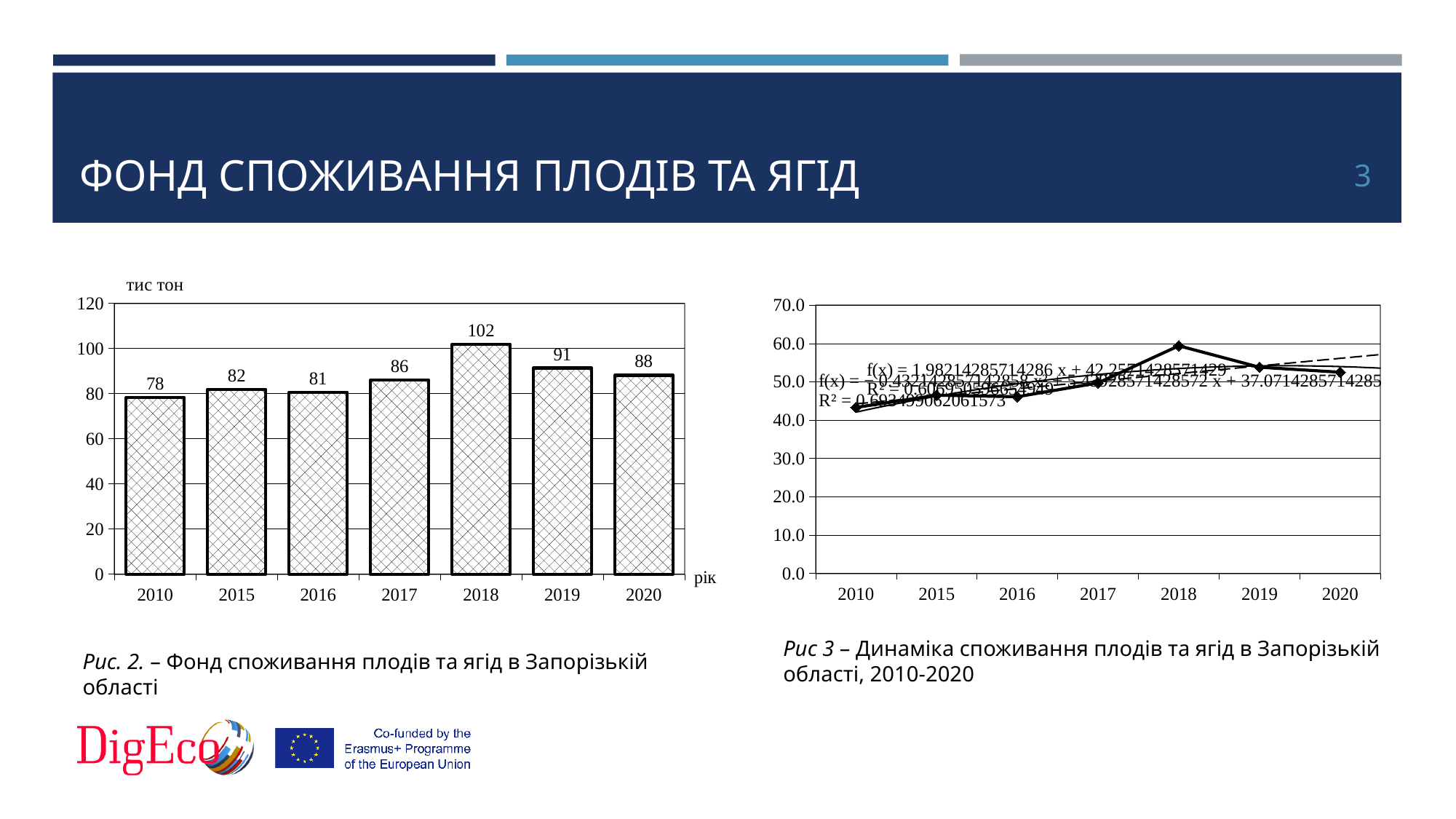
In the left chart (Рис. 2), what is the value for 2018? 102 In the left chart (Рис. 2), what is the value for 2010? 78 What kind of chart is the left chart (Рис. 2)? bar chart In the left chart (Рис. 2), what is the value for 2020? 88 In the left chart (Рис. 2), which year has the lowest value? 2010 In the right chart (Рис 3), is the value for 2018 greater or less than 50.0? greater In the left chart (Рис. 2), which is larger, the value for 2017 or the value for 2020? 2020 In the right chart (Рис 3), is the value for 2010 greater or less than 50.0? less In the left chart (Рис. 2), what is the difference between the values for 2018 and 2019? 11 In the left chart (Рис. 2), which year has the highest value? 2018 What unit is shown on the vertical axis of the left chart (Рис. 2)? тис тон How many bars are shown in the left chart (Рис. 2)? 7